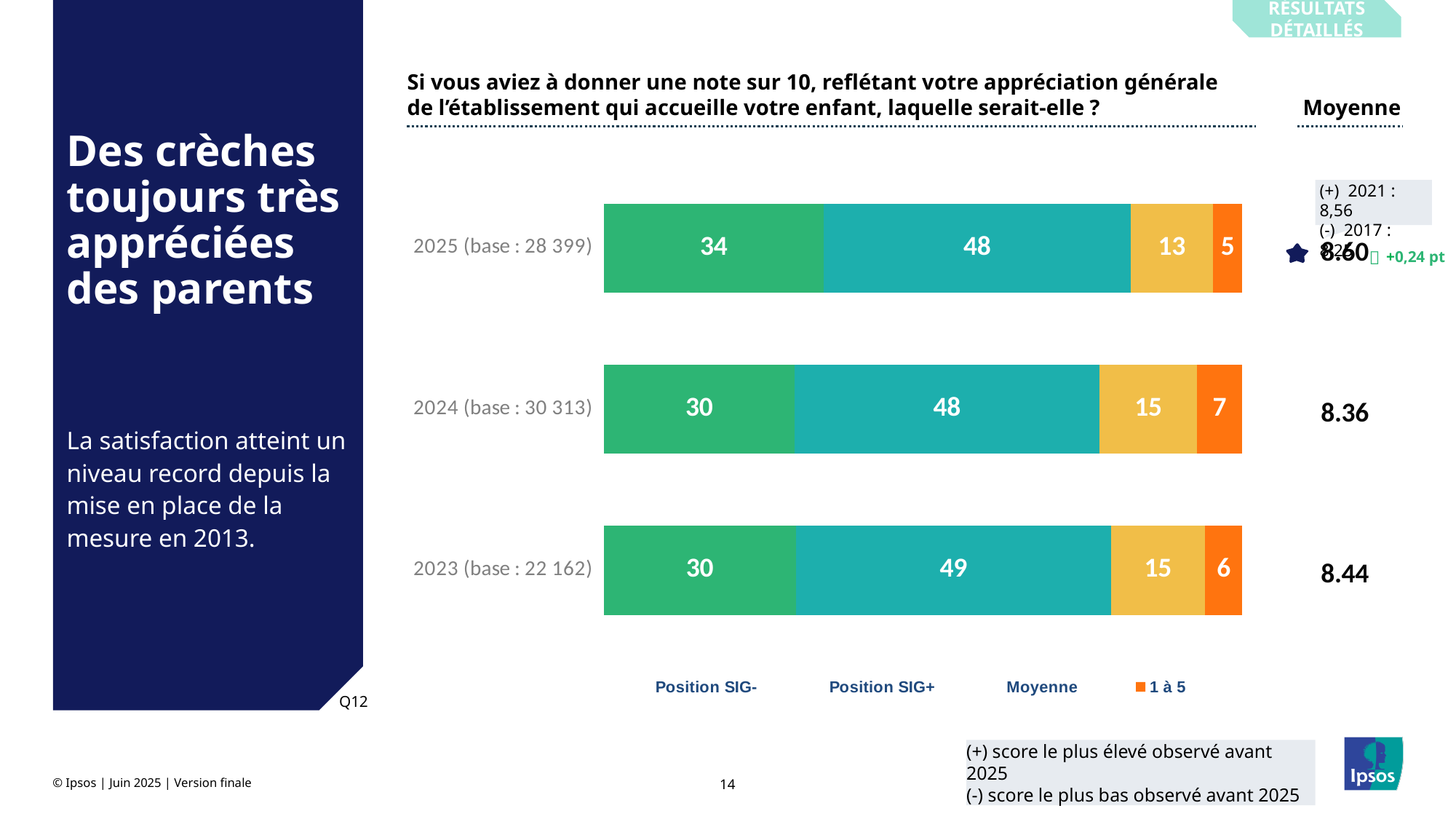
What is the 'Moyenne' (average score) shown for 2025? 8.60 What is the value of the second (teal) segment for 2023 (base : 22 162)? 49 Which year has the lowest value in the orange '1 à 5' segment? 2025 What is the value of the orange '1 à 5' segment for 2024 (base : 30 313)? 7 What is the 'Moyenne' (average score) shown for 2024? 8.36 What is the value of the first (green) segment for 2025 (base : 28 399)? 34 Is the yellow segment value larger for 2024 or for 2025? 2024 Which year has the highest value in the first (green) segment? 2025 What is the difference between the green segment values for 2025 and 2024? 4 What type of chart is shown on the slide? stacked bar chart How many series does the legend list? 4 How many year categories are plotted in the chart? 3